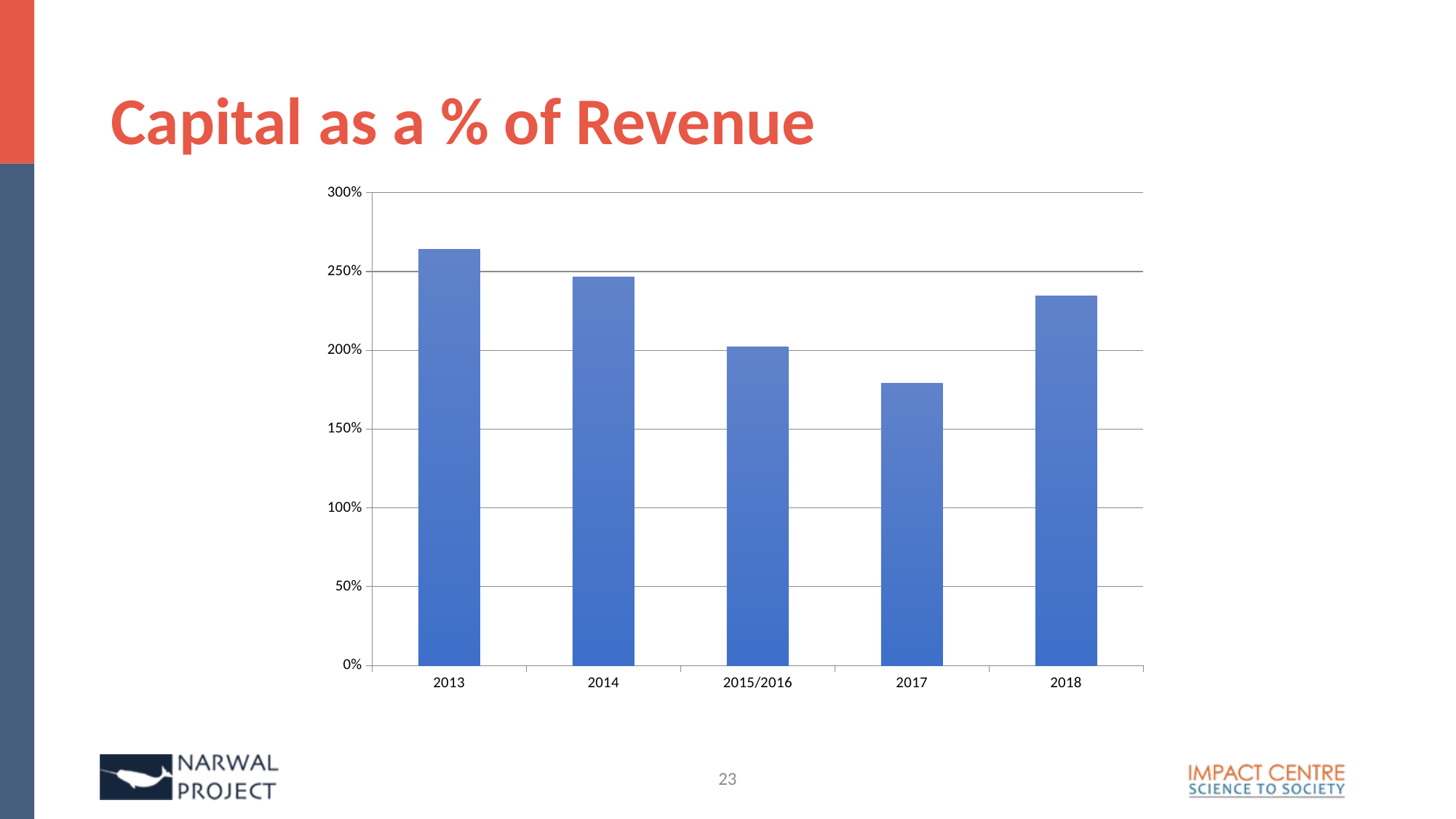
What is the title of the chart? Capital as a % of Revenue Which year has the highest capital as a % of revenue? 2013 Which year has the lowest capital as a % of revenue? 2017 What kind of chart is shown on the slide? Bar chart Which is larger, the value for 2018 or the value for 2015/2016? 2018 How many years (categories) are shown on the x axis? 5 From 2013 to 2017, do the values rise or fall? fall Which is larger, the value for 2013 or the value for 2018? 2013 Is the value for 2013 greater or less than 250%? greater Is the value for 2014 greater or less than 200%? greater Is the value for 2017 greater or less than 200%? less